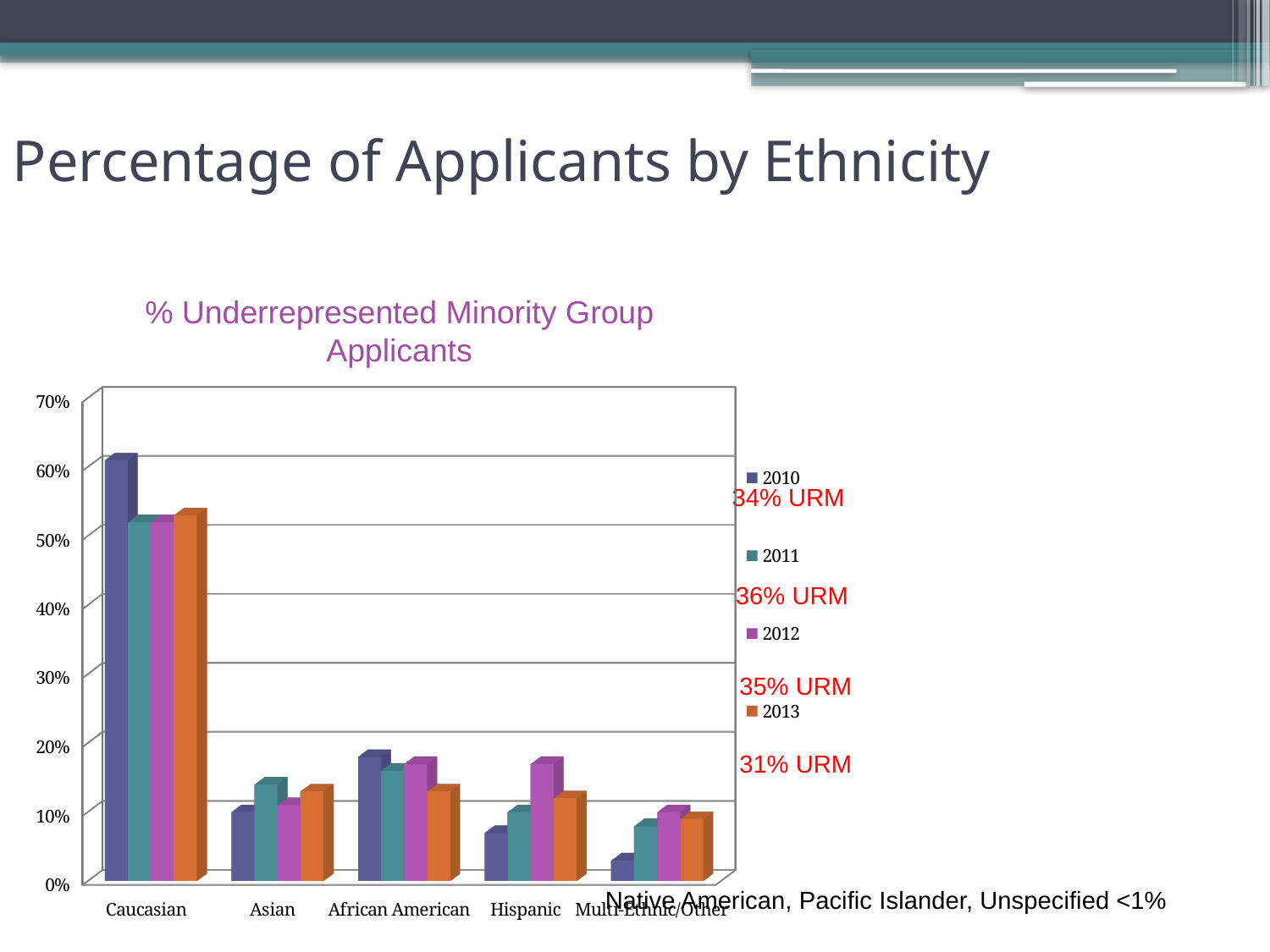
What kind of chart is shown on the slide? bar chart How many series does the chart's legend list? 4 Which ethnicity category has the lowest bar for 2010? Multi-Ethnic/Other Is the value for Caucasian in 2010 greater or less than 50%? greater Is the value for Multi-Ethnic/Other in 2010 greater or less than 10%? less Which ethnicity category has the highest bars in the chart? Caucasian Is the value for Asian in 2010 greater or less than 20%? less How many ethnicity categories are shown on the x axis of the chart? 5 Which is larger for Hispanic: the 2010 value or the 2012 value? 2012 What is the title of the chart? % Underrepresented Minority Group Applicants Which is larger for Caucasian: the 2010 value or the 2011 value? 2010